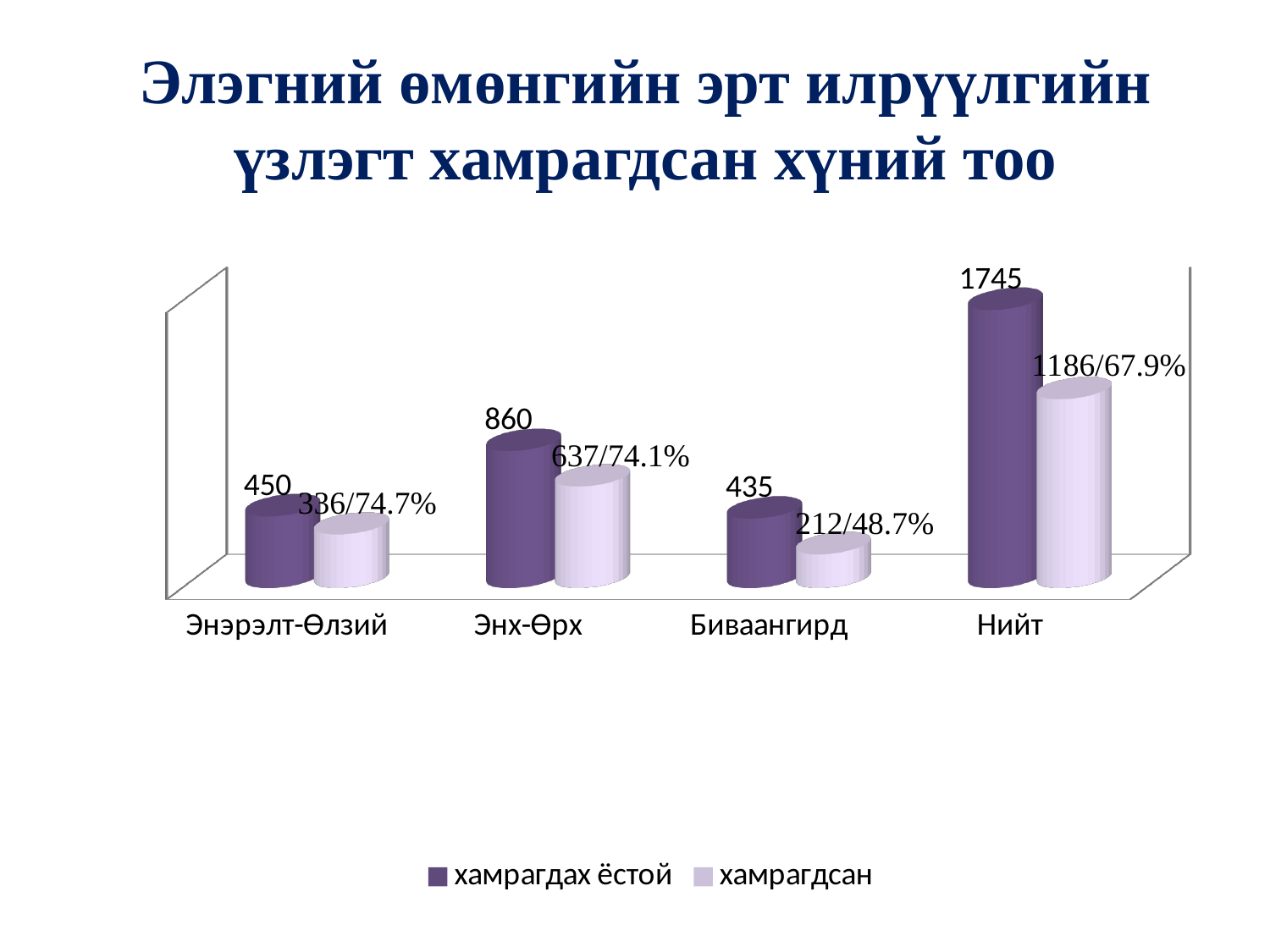
What is the difference between хамрагдах ёстой and хамрагдсан for Нийт? 559 What is the value of хамрагдах ёстой for Биваангирд? 435 Which category has the lowest хамрагдах ёстой value? Биваангирд What data label is shown for хамрагдсан at Биваангирд? 212/48.7% Which is larger, хамрагдах ёстой for Энэрэлт-Өлзий or for Энх-Өрх? Энх-Өрх How many categories are shown on the x axis? 4 What is the value of хамрагдах ёстой for Нийт? 1745 What kind of chart is shown on the slide? Bar chart How many series does the legend list? 2 What data label is shown for хамрагдсан at Нийт? 1186/67.9% What is the value of хамрагдах ёстой for Энх-Өрх? 860 Which category has the highest хамрагдах ёстой value? Нийт